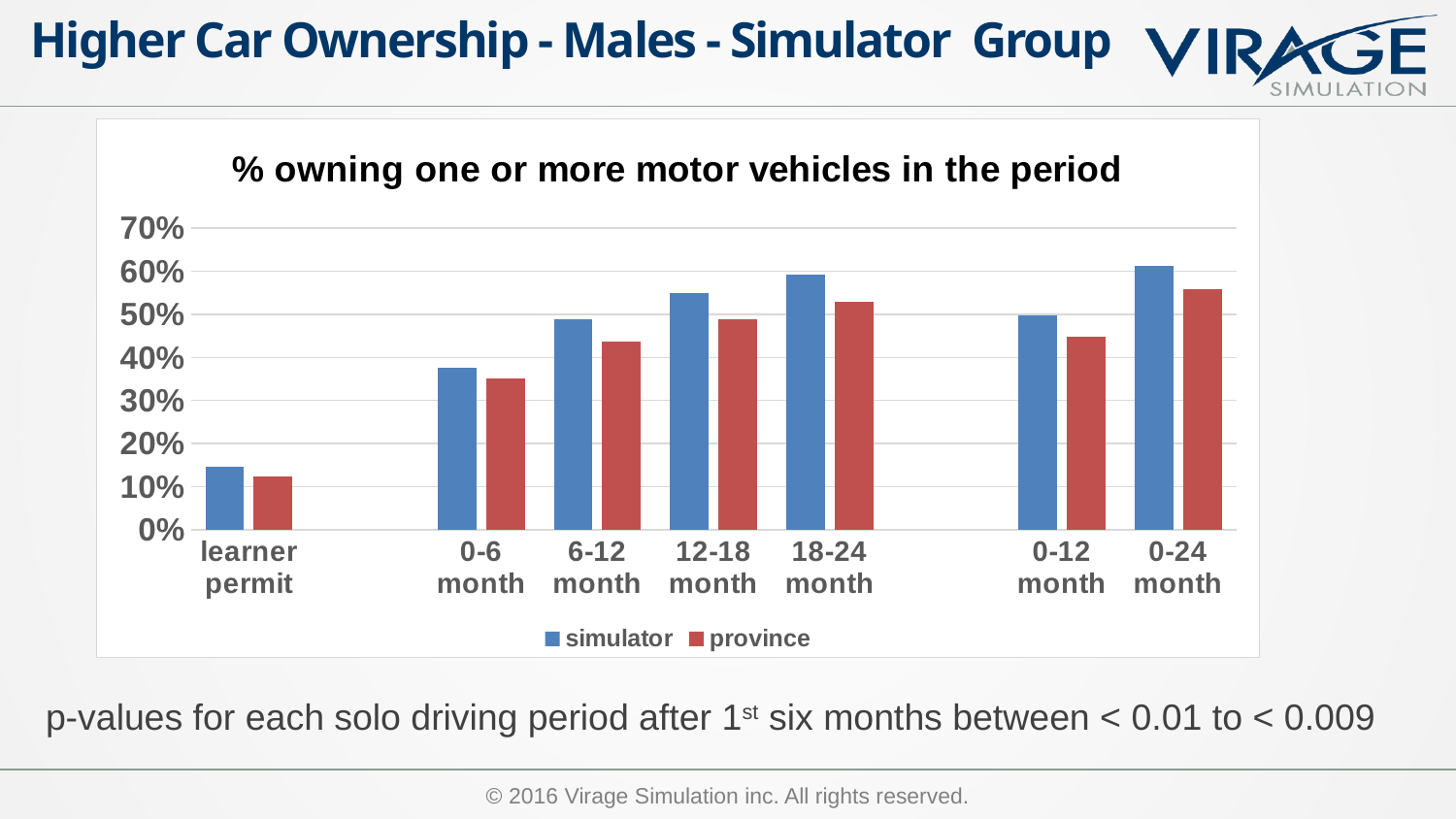
Which category has the lowest province value? learner permit What is the title of the chart? % owning one or more motor vehicles in the period Do the simulator values rise or fall from 0-6 month to 18-24 month? rise How many categories are shown on the x axis? 7 Which category has the highest simulator value? 0-24 month Is the simulator value for learner permit greater or less than 20%? less Is the province value for 0-6 month greater or less than 40%? less Is the simulator value for 12-18 month greater or less than 50%? greater For 18-24 month, which is larger, the simulator value or the province value? simulator What kind of chart is shown on the slide? bar chart How many series does the legend list? 2